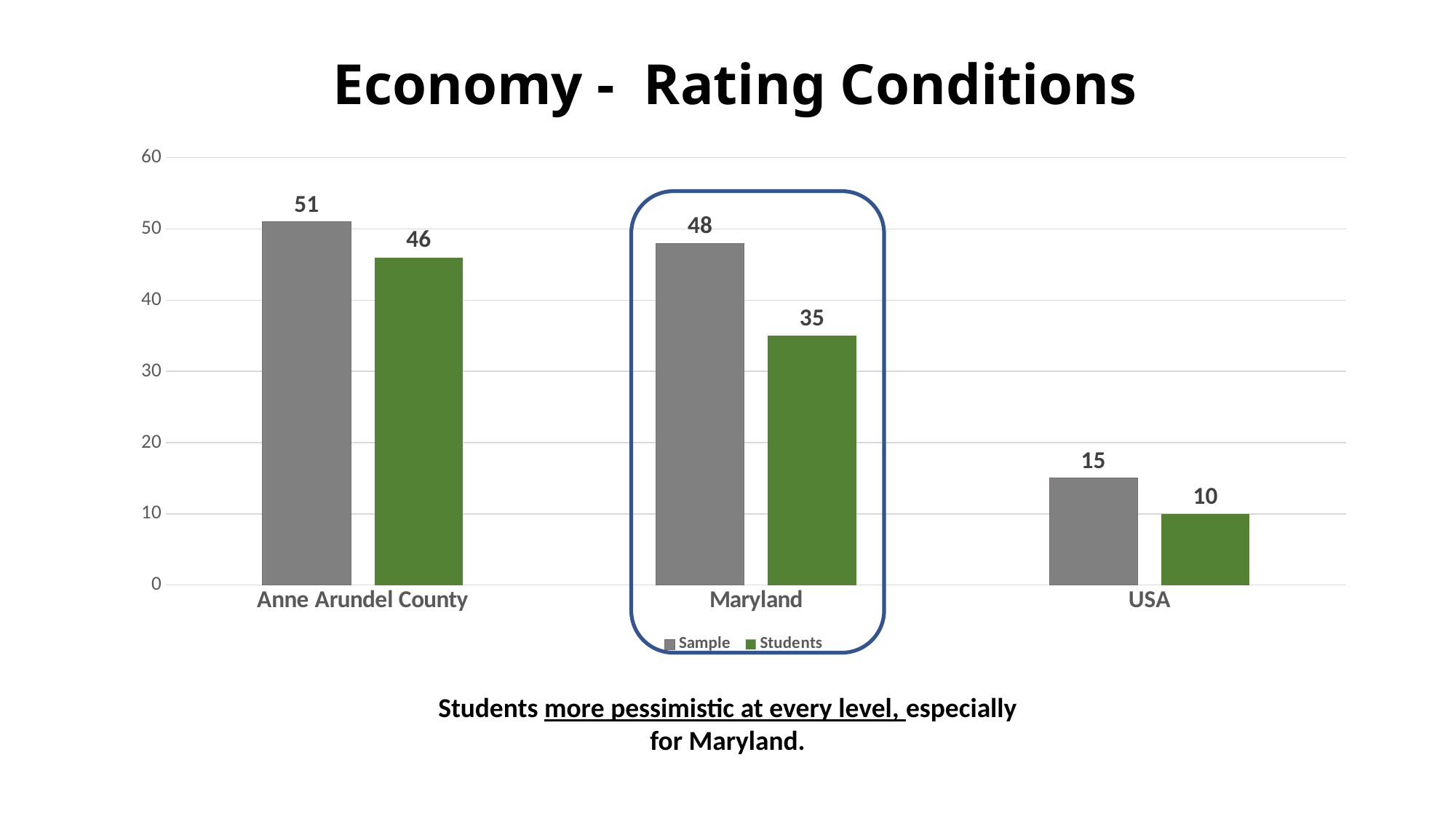
How many categories are shown on the x axis? 3 What is the Students value for Maryland? 35 What kind of chart is shown on the slide? Bar chart Which is larger for Anne Arundel County, the Sample value or the Students value? Sample How many series does the legend list? 2 What is the difference between the Sample values for Anne Arundel County and USA? 36 What is the title of the chart? Economy - Rating Conditions What is the Sample value for Anne Arundel County? 51 Which category has the lowest Students value? USA What is the Students value for USA? 10 What is the difference between the Sample and Students values for Maryland? 13 Which category has the highest Sample value? Anne Arundel County